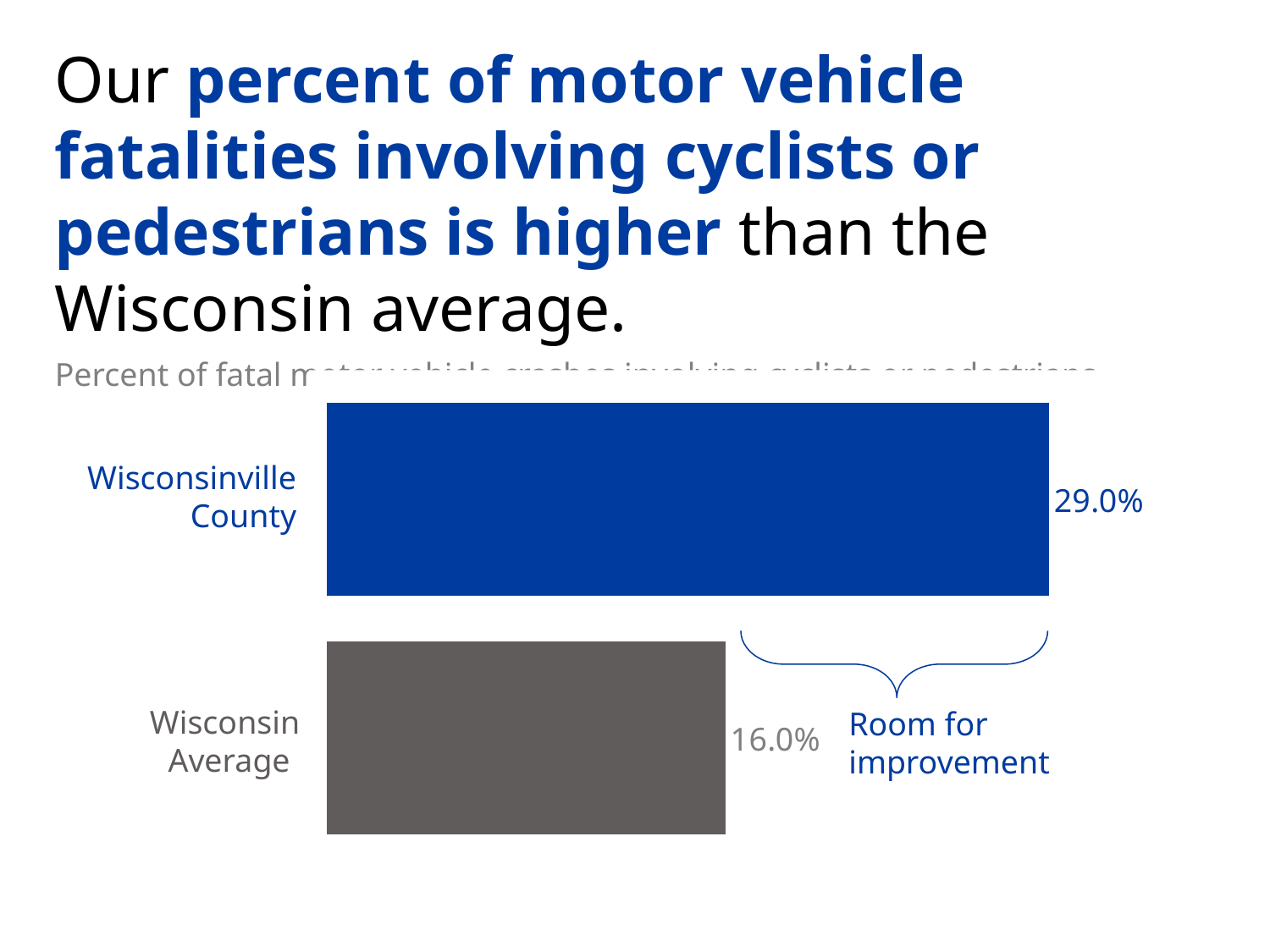
What is the value for Wisconsin Average? 16.0% What colour is the bar for Wisconsinville County? Blue How many categories are shown in the chart? 2 What is the difference between the Wisconsinville County value and the Wisconsin Average value? 13.0% What is the value for Wisconsinville County? 29.0% Which category has the highest value? Wisconsinville County Which is larger, the value for Wisconsinville County or the value for Wisconsin Average? Wisconsinville County What kind of chart is shown on the slide? Bar chart Which category has the lowest value? Wisconsin Average What text is written below the bracket between the two bars? Room for improvement